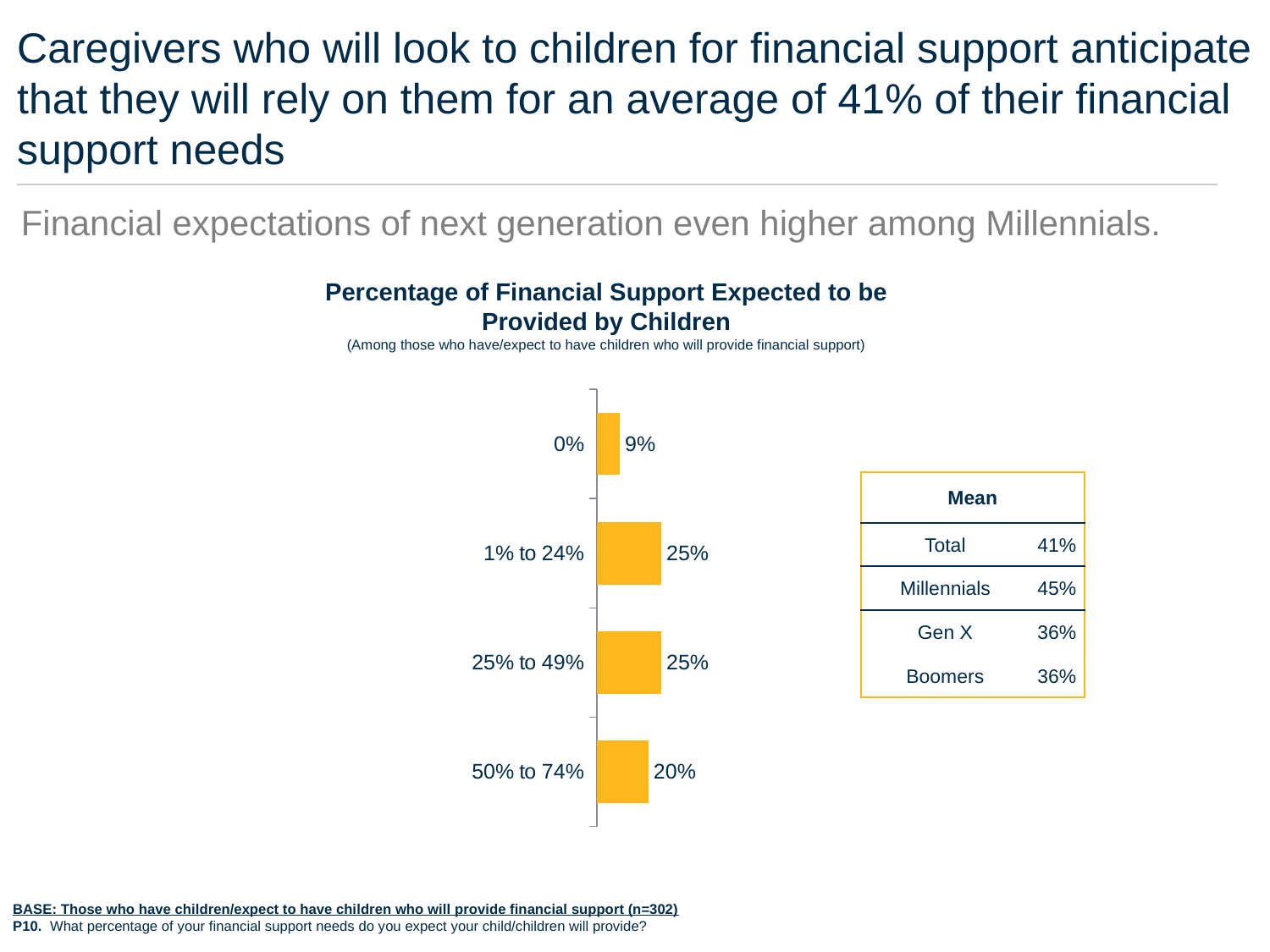
What is the value shown for the "50% to 74%" category? 20% According to the Mean table, what is the mean for Millennials? 45% What percentage of respondents expect children to provide 0% of their financial support needs? 9% What is the difference between the values for "50% to 74%" and "0%"? 11% Which is larger, the value for "50% to 74%" or the value for "0%"? 50% to 74% What is the title of the chart? Percentage of Financial Support Expected to be Provided by Children What type of chart is shown on the slide? Bar chart What is the difference between the values for "1% to 24%" and "50% to 74%"? 5% What is the value shown for the "25% to 49%" category? 25% What is the value shown for the "1% to 24%" category? 25% According to the Mean table, what is the mean for Gen X? 36% Which category has the lowest value in the chart? 0%